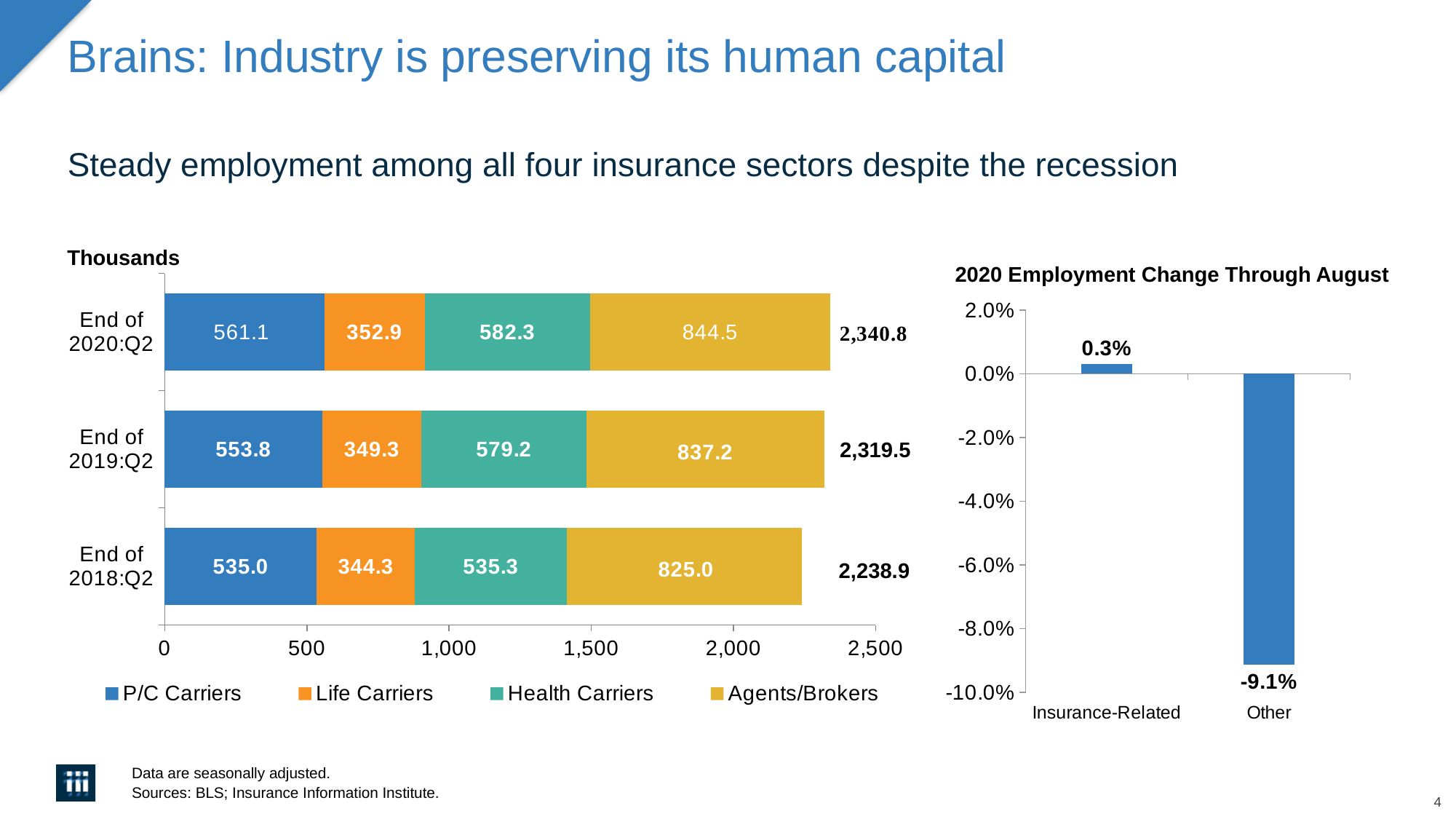
In the left stacked bar chart, which series has the lowest value at End of 2020:Q2? Life Carriers In the chart titled '2020 Employment Change Through August', what is the value for Insurance-Related? 0.3% In the left stacked bar chart, what is the total for the End of 2019:Q2 bar? 2,319.5 In the left stacked bar chart, which period has the highest total employment? End of 2020:Q2 What kind of chart is the chart titled '2020 Employment Change Through August'? Bar chart In the chart titled '2020 Employment Change Through August', how many categories are shown? 2 In the left stacked bar chart, how many series does the legend list? 4 In the left stacked bar chart, is the P/C Carriers value at End of 2020:Q2 larger or smaller than at End of 2018:Q2? larger In the left stacked bar chart, what is the difference between the Health Carriers values for End of 2019:Q2 and End of 2018:Q2? 43.9 In the chart titled '2020 Employment Change Through August', what is the value for Other? -9.1% In the left stacked bar chart, what is the value for Agents/Brokers at End of 2020:Q2? 844.5 In the left stacked bar chart, what is the value for Life Carriers at End of 2018:Q2? 344.3